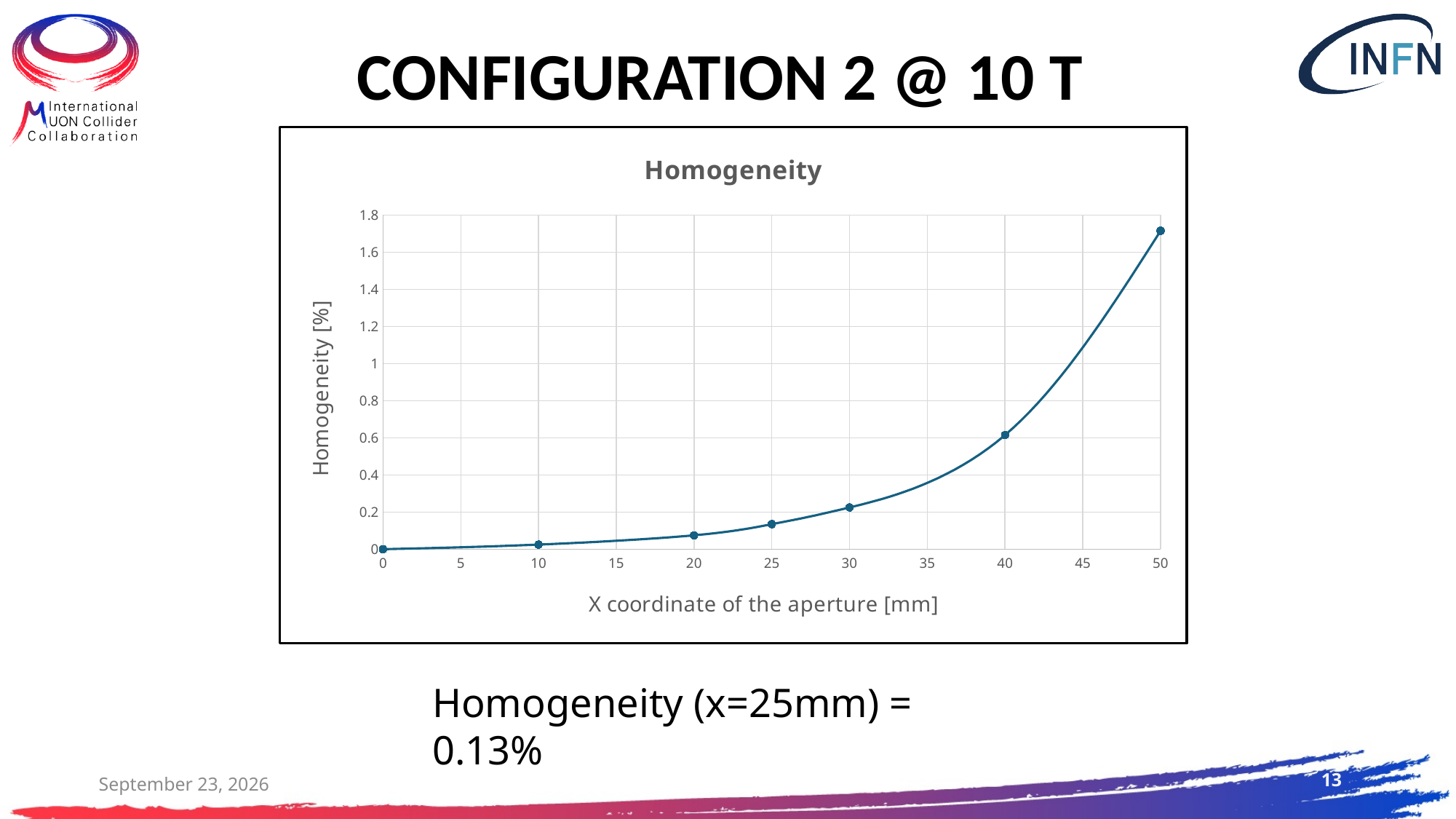
At which x coordinate is the homogeneity lowest? 0 Is the homogeneity at x = 50 mm greater or less than 1.6? greater What kind of chart is shown on the slide? line chart Which is larger, the homogeneity at x = 40 mm or at x = 30 mm? x = 40 mm What is the title of the chart? Homogeneity What is the homogeneity at x = 25 mm? 0.13% Is the homogeneity at x = 30 mm greater or less than 0.4? less How many data points are plotted on the chart? 7 What is the label of the x axis of the chart? X coordinate of the aperture [mm] Is the homogeneity at x = 40 mm greater or less than 0.8? less At which x coordinate is the homogeneity highest? 50 Does the homogeneity rise or fall as the x coordinate increases? rise